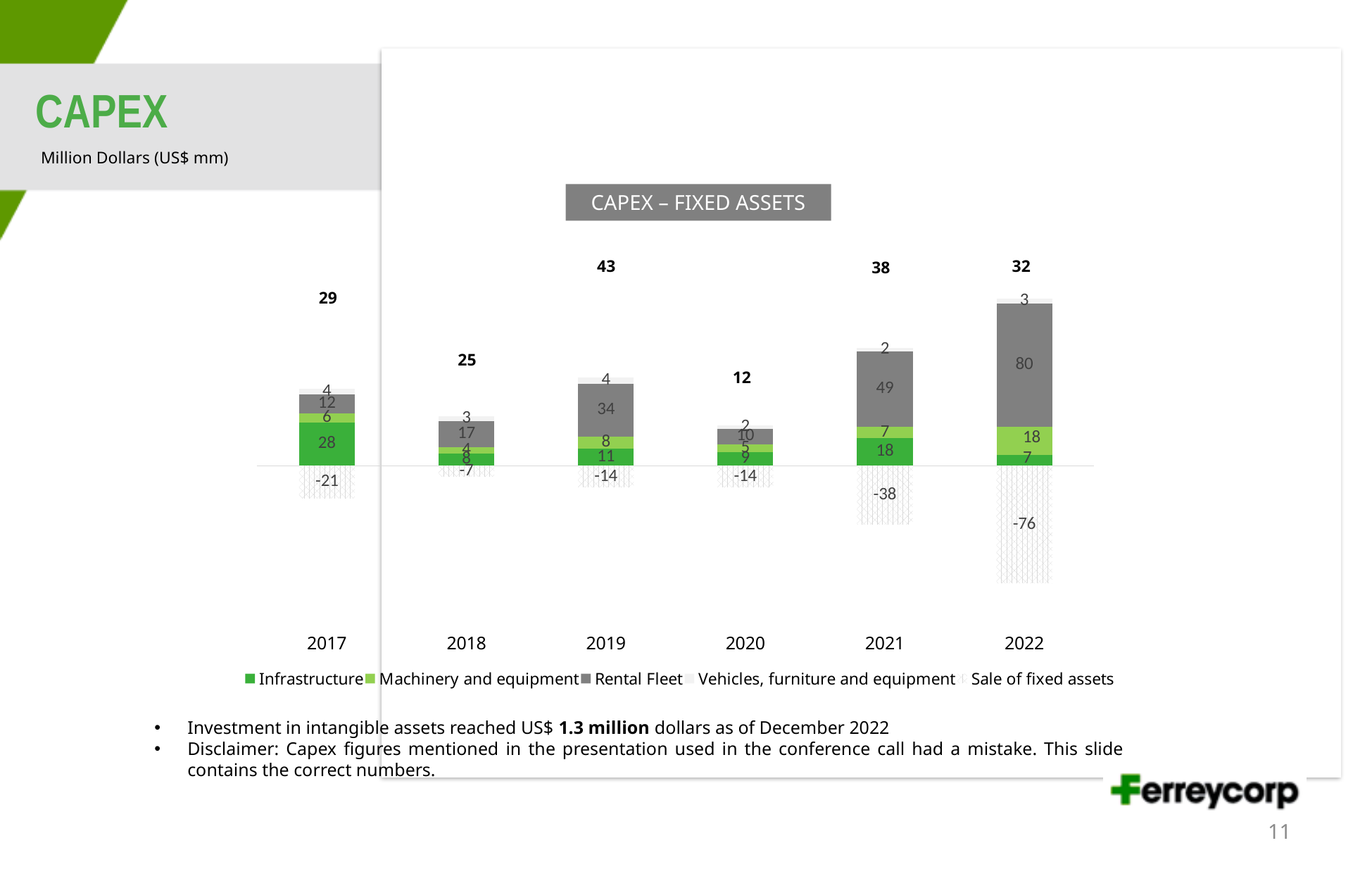
What is the difference between the Rental Fleet values for 2022 and 2021? 31 What type of chart is shown on the slide? Stacked bar chart What is the Infrastructure value for 2017? 28 How many years are shown on the x axis? 6 What is the Rental Fleet value for 2022? 80 What is the title of the chart? CAPEX – FIXED ASSETS What is the net total shown above the bar for 2019? 43 Which is larger, the Machinery and equipment value for 2022 or for 2021? 2022 What is the Sale of fixed assets value for 2021? -38 Which year has the lowest net total? 2020 How many series does the legend list? 5 Which year has the highest net total? 2019